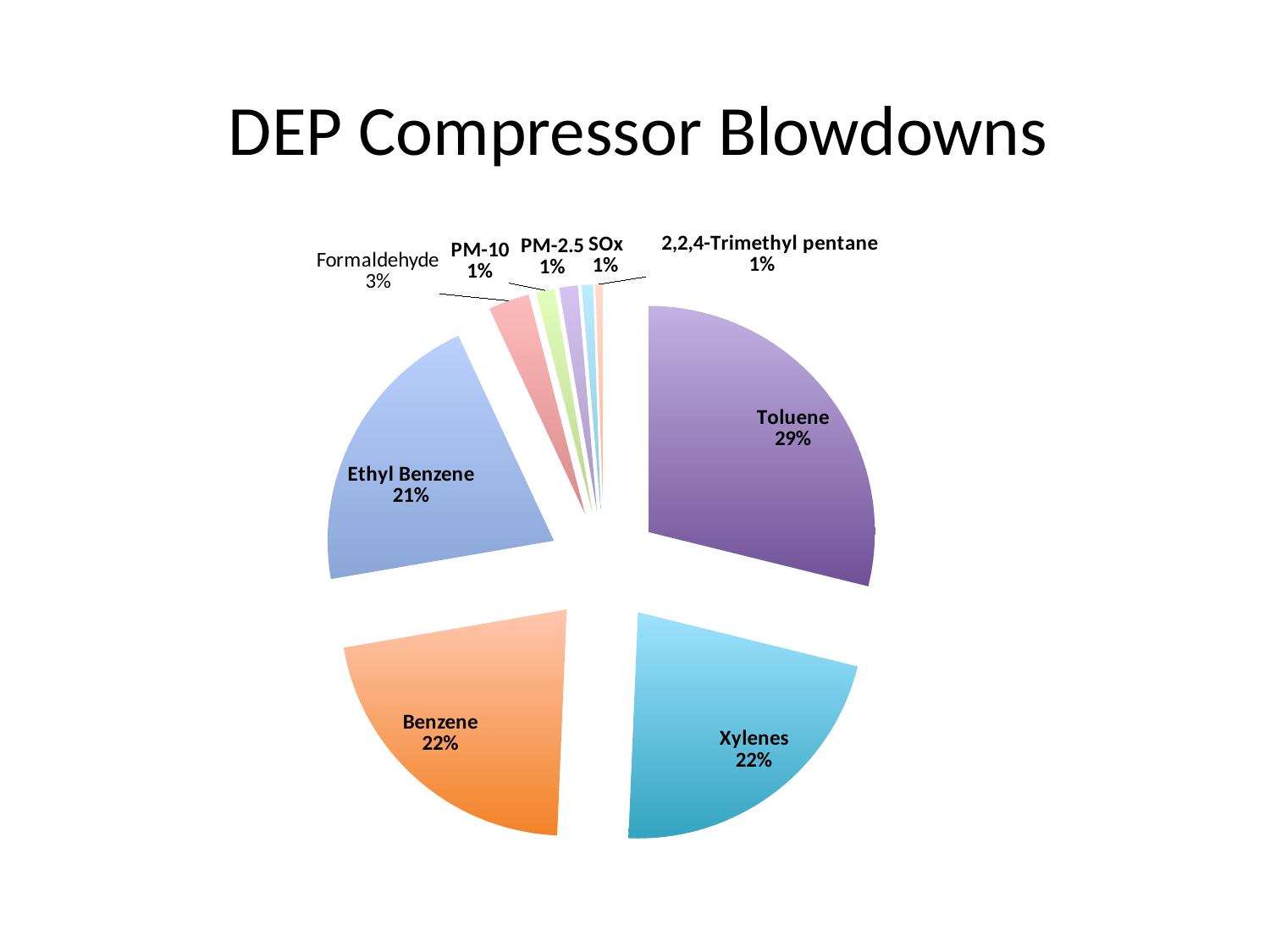
What is the value shown for Xylenes? 22% Which is larger, the share for Benzene or the share for Formaldehyde? Benzene What is the difference in percentage points between Toluene and Ethyl Benzene? 8 What is the difference in percentage points between Formaldehyde and PM-10? 2 What kind of chart is shown on the slide? pie chart What share of the pie does Ethyl Benzene represent? 21% Which category has the largest slice of the pie? Toluene What share of the pie does Formaldehyde represent? 3% What is the title of the chart? DEP Compressor Blowdowns What share of the pie does Toluene represent? 29% How many slices does the pie chart have? 9 What is the value shown for 2,2,4-Trimethyl pentane? 1%